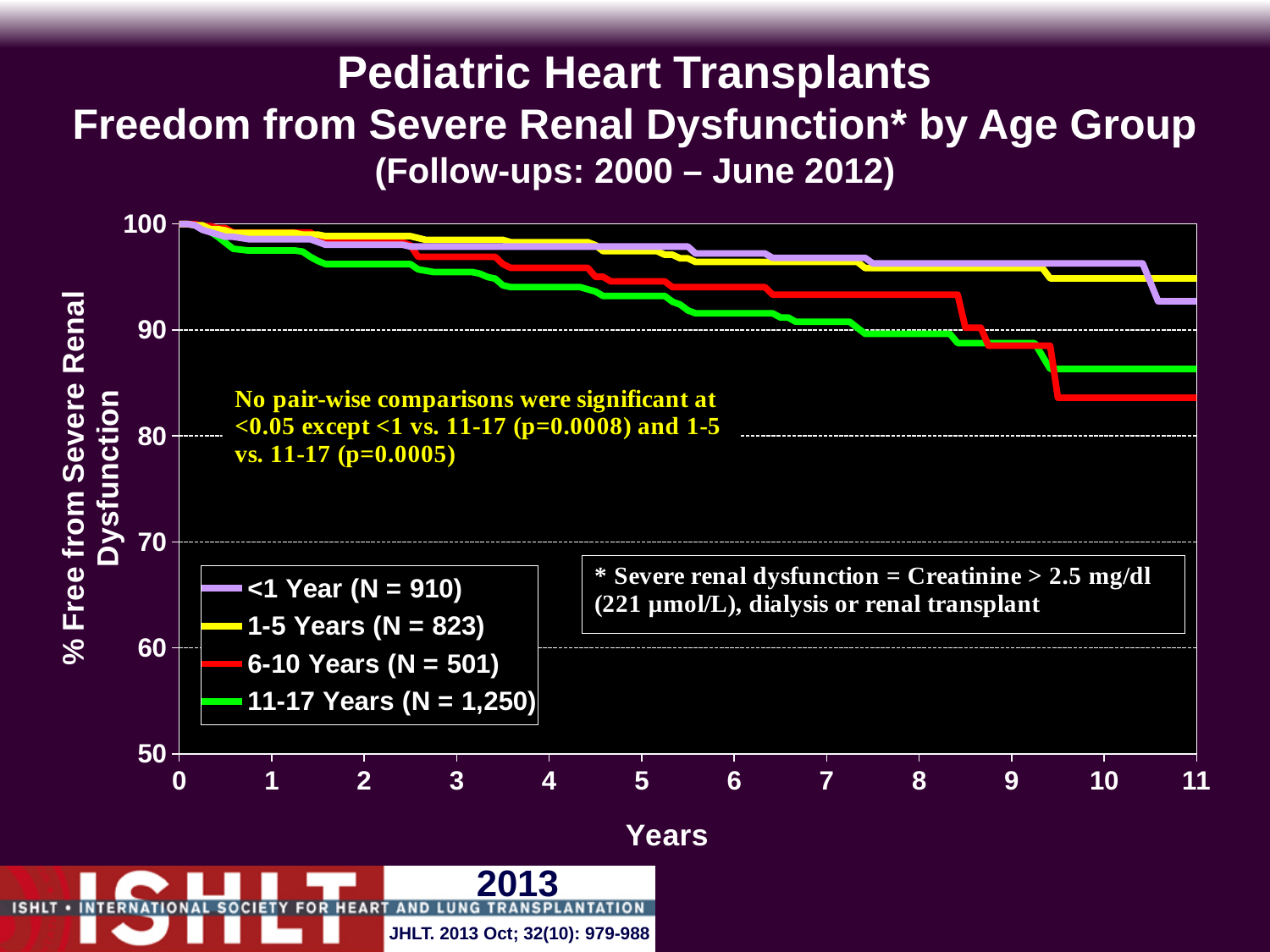
What is the label of the x axis? Years At year 11, which is larger: the value for 1-5 Years or the value for 11-17 Years? 1-5 Years Which age group has the lowest value at year 11? 6-10 Years Do the values for the 11-17 Years series rise or fall as years increase? fall Is the value for the 11-17 Years series at year 11 greater or less than 90? less What kind of chart is shown on the slide? line chart Is the value for the 11-17 Years series at year 5 greater or less than 90? greater What is the N for the 11-17 Years group shown in the legend? 1,250 How many series does the legend list? 4 Is the value for the 6-10 Years series at year 11 greater or less than 90? less Which age group has the highest value at year 11? 1-5 Years